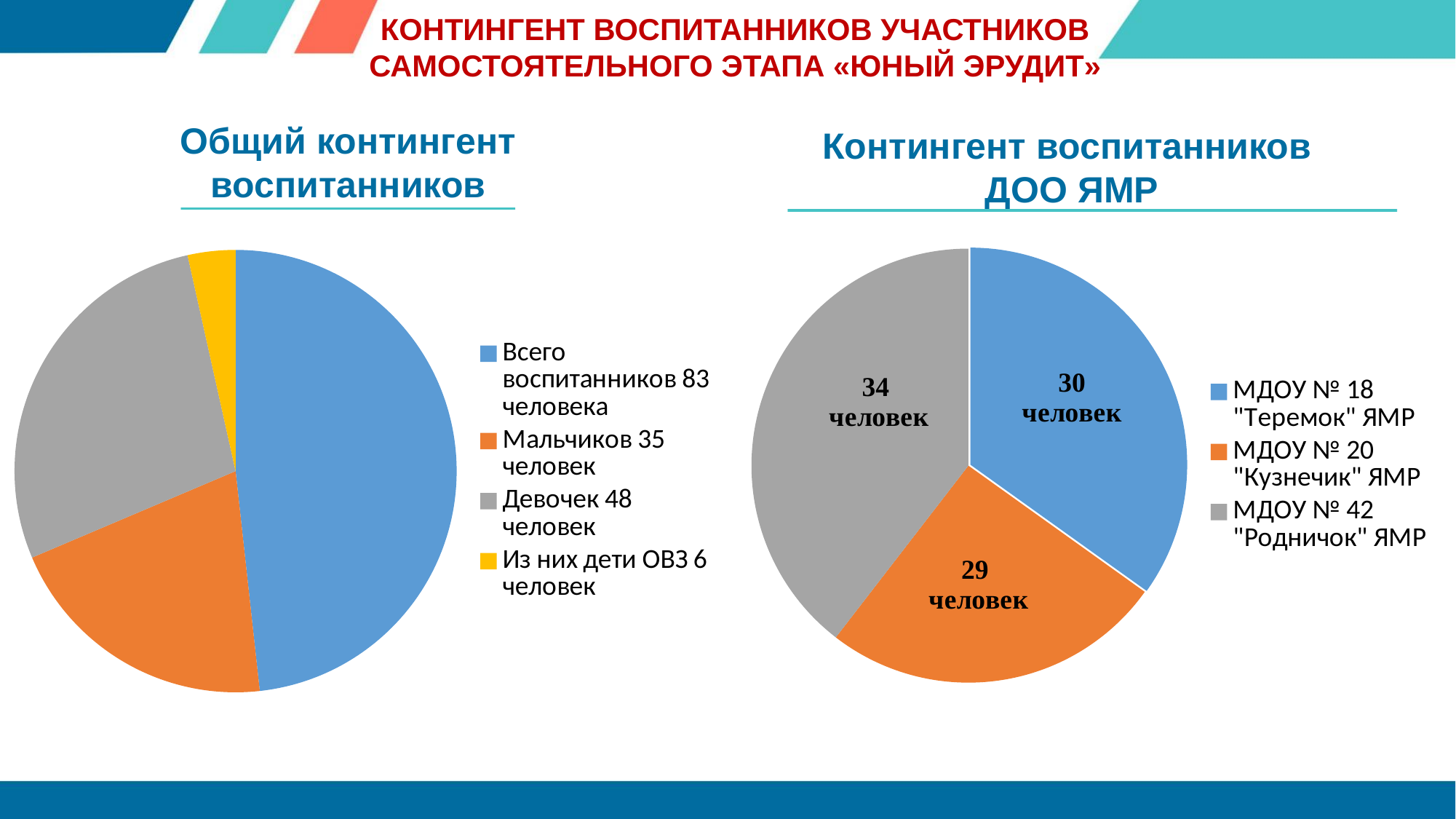
On the left chart "Общий контингент воспитанников", how many boys (Мальчиков) are there according to the legend? 35 человек On the right chart "Контингент воспитанников ДОО ЯМР", which institution has the smallest slice? МДОУ № 20 "Кузнечик" ЯМР On the right chart "Контингент воспитанников ДОО ЯМР", how many children are from МДОУ № 42 "Родничок" ЯМР? 34 человек What type of chart is the left chart "Общий контингент воспитанников"? Pie chart On the right chart "Контингент воспитанников ДОО ЯМР", how many slices does the pie have? 3 On the right chart "Контингент воспитанников ДОО ЯМР", what is the difference between the number of children from МДОУ № 42 "Родничок" and from МДОУ № 18 "Теремок"? 4 On the left chart "Общий контингент воспитанников", which legend category is represented by the yellow slice? Из них дети ОВЗ 6 человек On the right chart "Контингент воспитанников ДОО ЯМР", how many children are from МДОУ № 18 "Теремок" ЯМР? 30 человек On the right chart "Контингент воспитанников ДОО ЯМР", which institution has the largest slice? МДОУ № 42 "Родничок" ЯМР On the right chart "Контингент воспитанников ДОО ЯМР", how many children are from МДОУ № 20 "Кузнечик" ЯМР? 29 человек On the left chart "Общий контингент воспитанников", how many girls (Девочек) are there according to the legend? 48 человек On the left chart "Общий контингент воспитанников", how many children with ОВЗ are there according to the legend? 6 человек